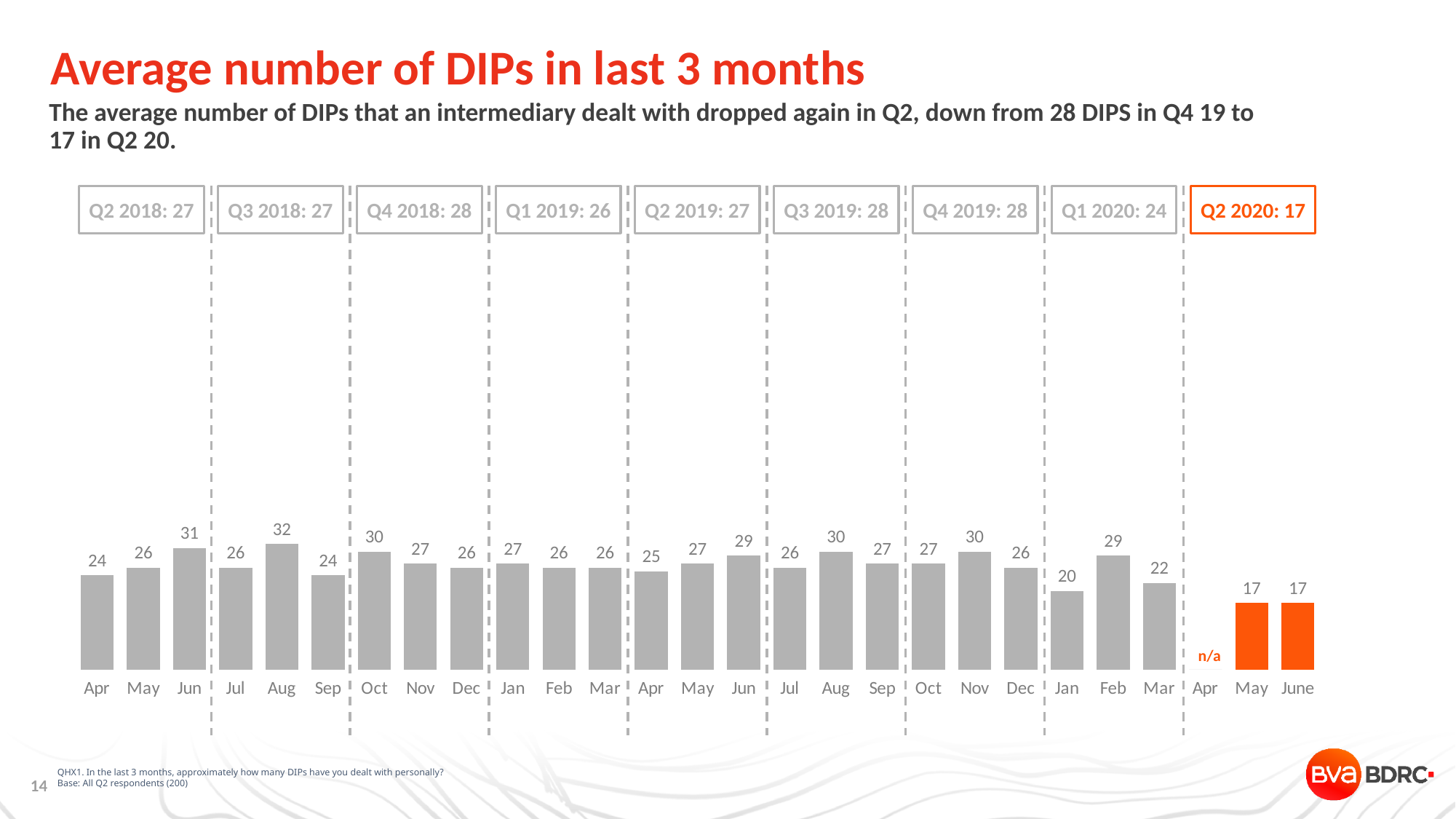
What is the value for June in Q2 2020? 17 What is the value for Jan in Q1 2020? 20 What is shown for Apr 2020 instead of a bar value? n/a What is the quarterly average shown in the box for Q4 2018? 28 Which is larger, the value for Feb 2020 or the value for Mar 2020? Feb 2020 What is the quarterly average shown in the box for Q2 2020? 17 Which month has the highest bar in the chart? Aug 2018 What is the lowest value shown on any bar in the chart? 17 What is the difference between the value for Aug 2018 and the value for Sep 2018? 8 How many quarterly average boxes are shown above the chart? 9 What kind of chart is shown on the slide? bar chart What is the value for Aug in Q3 2018? 32